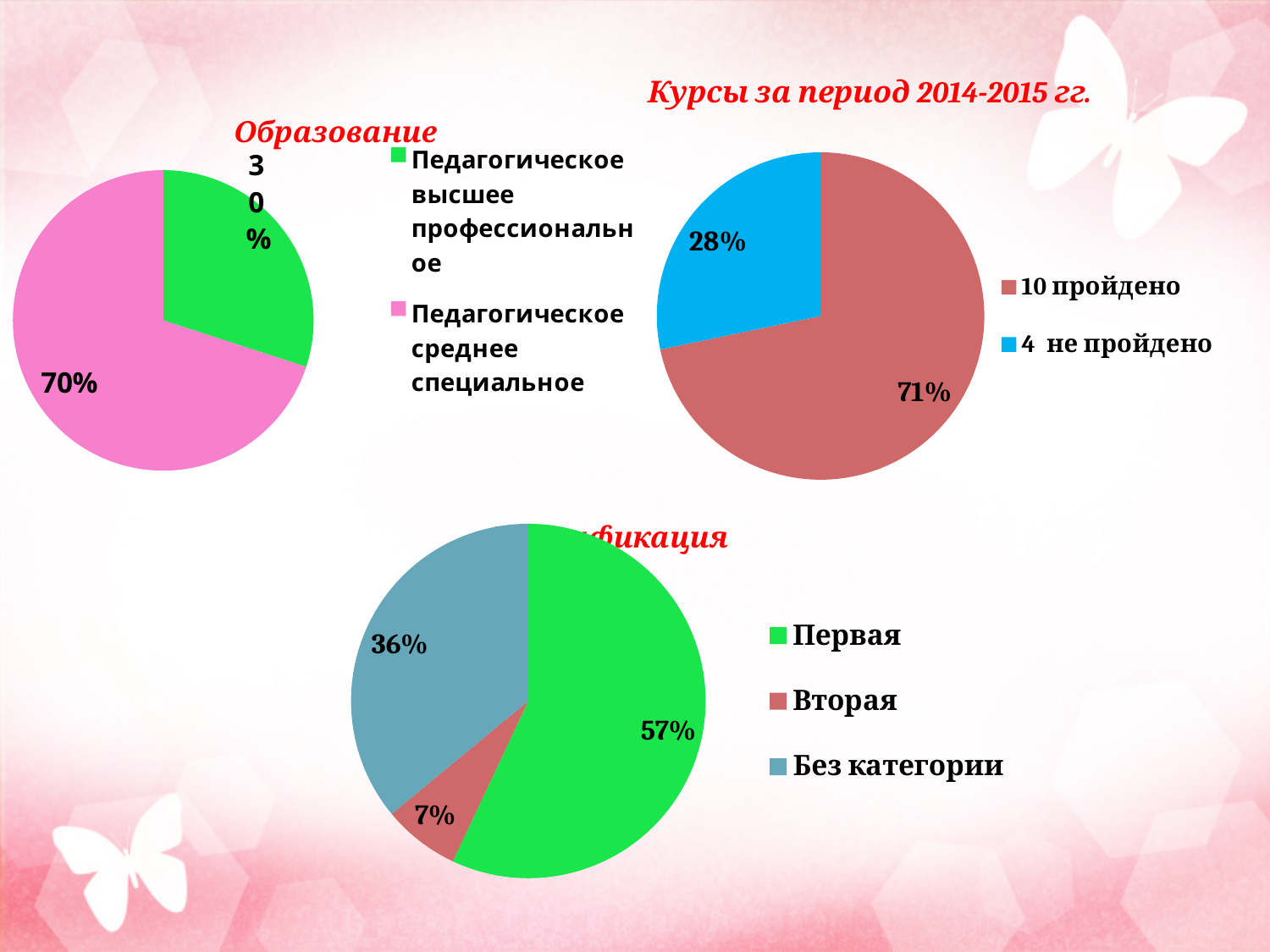
In the 'Образование' chart, what share is shown for 'Педагогическое высшее профессиональное'? 30% In the bottom pie chart, which category has the smallest share? Вторая In the bottom pie chart, what is the difference between the 'Без категории' and 'Вторая' shares? 29% In the 'Образование' chart, what share is shown for 'Педагогическое среднее специальное'? 70% In the 'Курсы за период 2014-2015 гг.' chart, what is the difference between the '10 пройдено' and '4 не пройдено' shares? 43% What type of chart is the 'Образование' chart? Pie chart In the 'Курсы за период 2014-2015 гг.' chart, what share is shown for '4 не пройдено'? 28% In the 'Курсы за период 2014-2015 гг.' chart, what share is shown for '10 пройдено'? 71% In the bottom pie chart, what share is shown for 'Первая'? 57% How many entries does the legend of the 'Курсы за период 2014-2015 гг.' chart list? 2 How many slices does the bottom pie chart have? 3 In the 'Образование' chart, which category has the larger share? Педагогическое среднее специальное